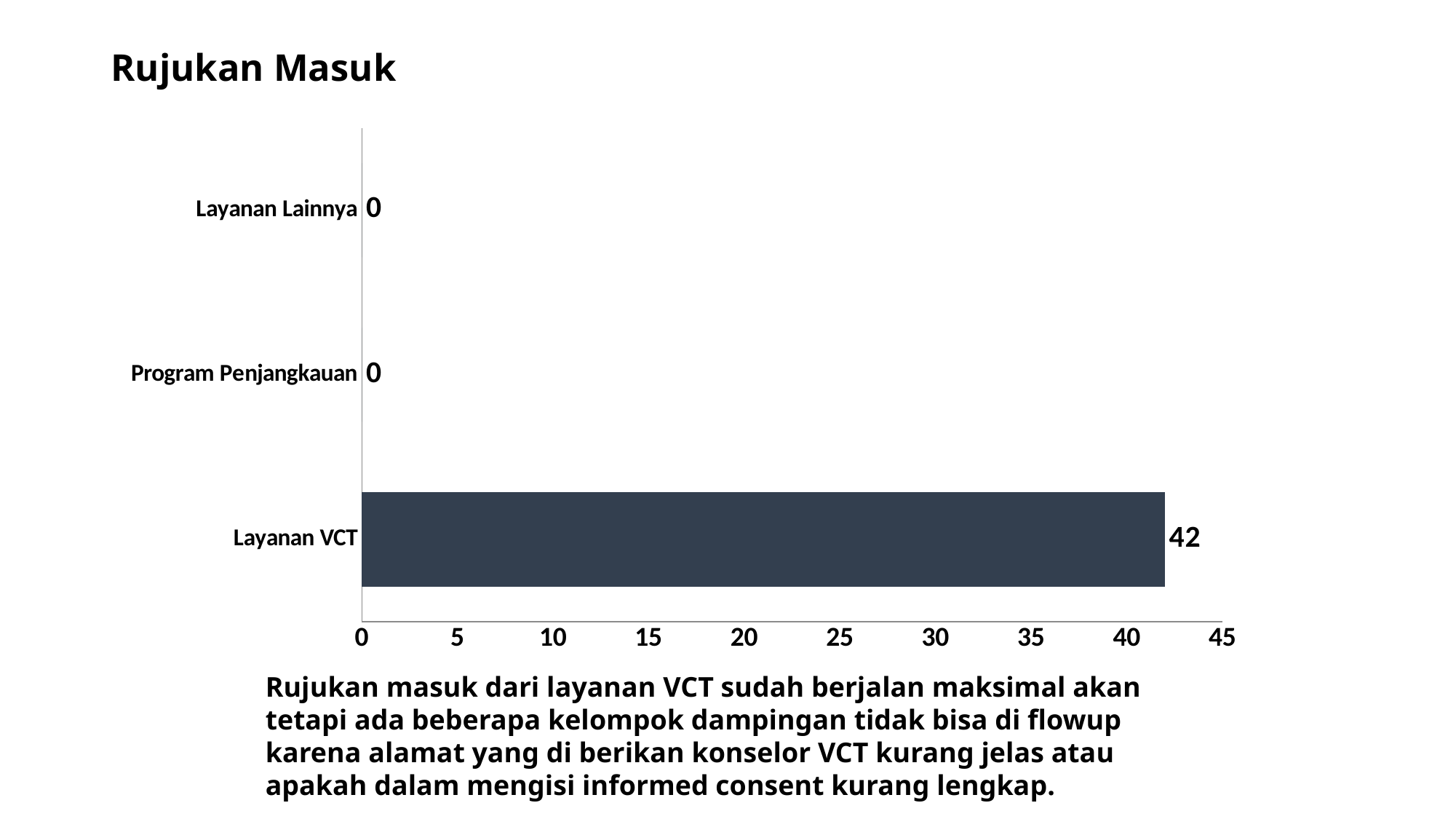
How many categories have a value of 0? 2 What is the value for Program Penjangkauan? 0 What is the value for Layanan VCT? 42 How many categories are shown on the chart? 3 What is the difference between the values for Layanan VCT and Program Penjangkauan? 42 What is the value for Layanan Lainnya? 0 What is the title of the chart? Rujukan Masuk Is the value for Layanan VCT greater or less than 40? greater What is the highest value shown on the x axis? 45 What kind of chart is shown on the slide? bar chart Which is larger, the value for Layanan VCT or the value for Layanan Lainnya? Layanan VCT Which category has the highest value? Layanan VCT